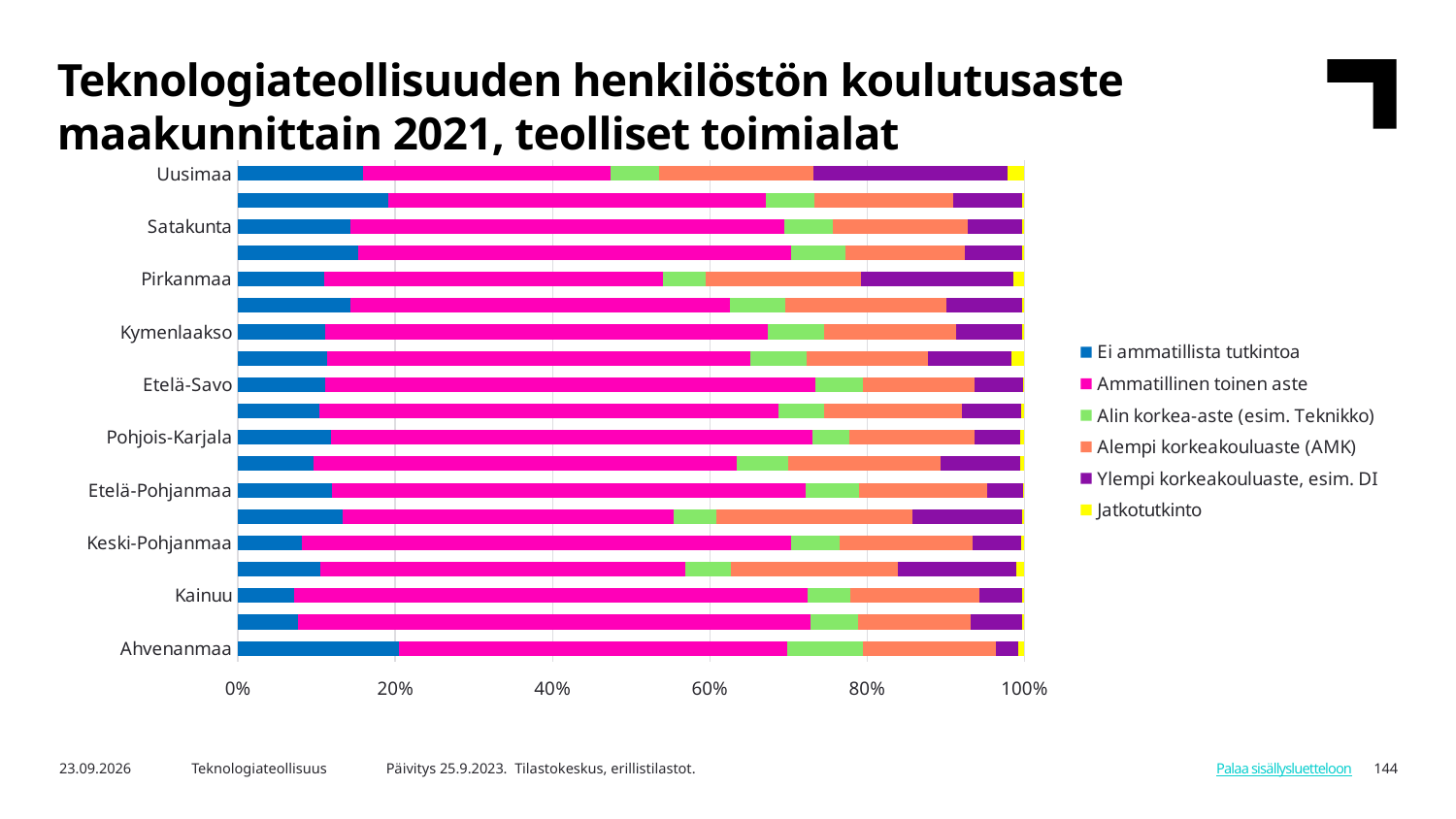
Which has a larger Ammatillinen toinen aste share, Uusimaa or Ahvenanmaa? Ahvenanmaa Is the Ei ammatillista tutkintoa share for Uusimaa greater or less than 20%? less Which has a larger Ylempi korkeakouluaste, esim. DI share, Uusimaa or Kainuu? Uusimaa Is the Ammatillinen toinen aste share for Uusimaa greater or less than 20%? greater Is the Ei ammatillista tutkintoa share for Kainuu greater or less than 20%? less What is the title of the chart? Teknologiateollisuuden henkilöstön koulutusaste maakunnittain 2021, teolliset toimialat Among the labelled regions, which has the largest Ylempi korkeakouluaste, esim. DI share? Uusimaa What kind of chart is shown on the slide? Stacked bar chart Which colour represents Jatkotutkinto in the legend? Yellow Which has a larger Ei ammatillista tutkintoa share, Kainuu or Ahvenanmaa? Ahvenanmaa How many series does the legend list? 6